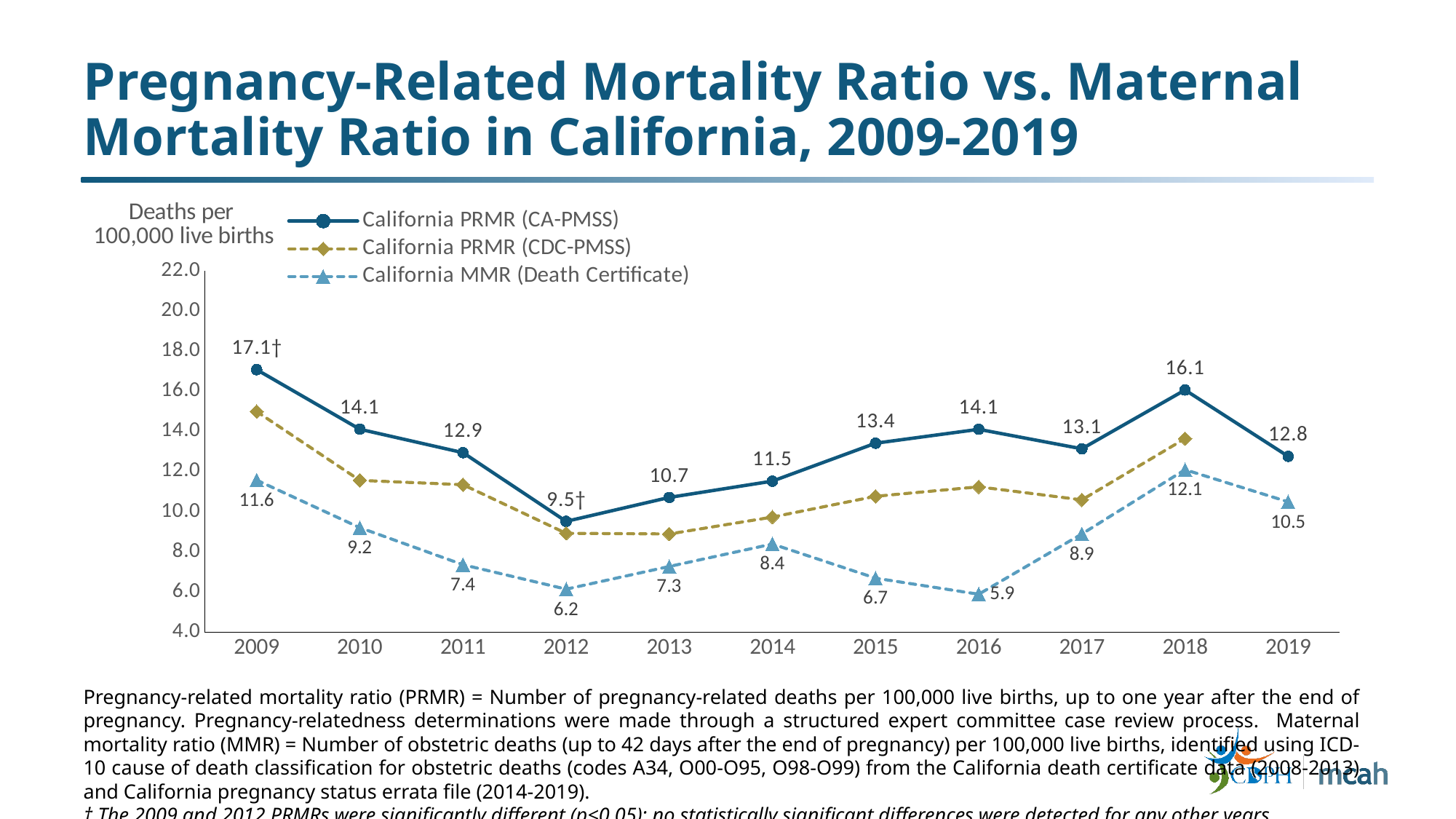
How many years are shown on the x axis? 11 Is the California PRMR (CDC-PMSS) value for 2009 greater or less than 14.0? greater In which year is the California MMR (Death Certificate) highest? 2018 What kind of chart is shown on the slide? line chart What is the California PRMR (CA-PMSS) value for 2009? 17.1 In which year is the California PRMR (CA-PMSS) lowest? 2012 How many series does the legend list? 3 Does the California PRMR (CA-PMSS) rise or fall from 2009 to 2012? fall What is the California MMR (Death Certificate) value for 2016? 5.9 Which is larger in 2012: the California PRMR (CA-PMSS) or the California MMR (Death Certificate)? California PRMR (CA-PMSS) What is the difference between the California PRMR (CA-PMSS) and the California MMR (Death Certificate) in 2019? 2.3 What is the California PRMR (CA-PMSS) value for 2018? 16.1